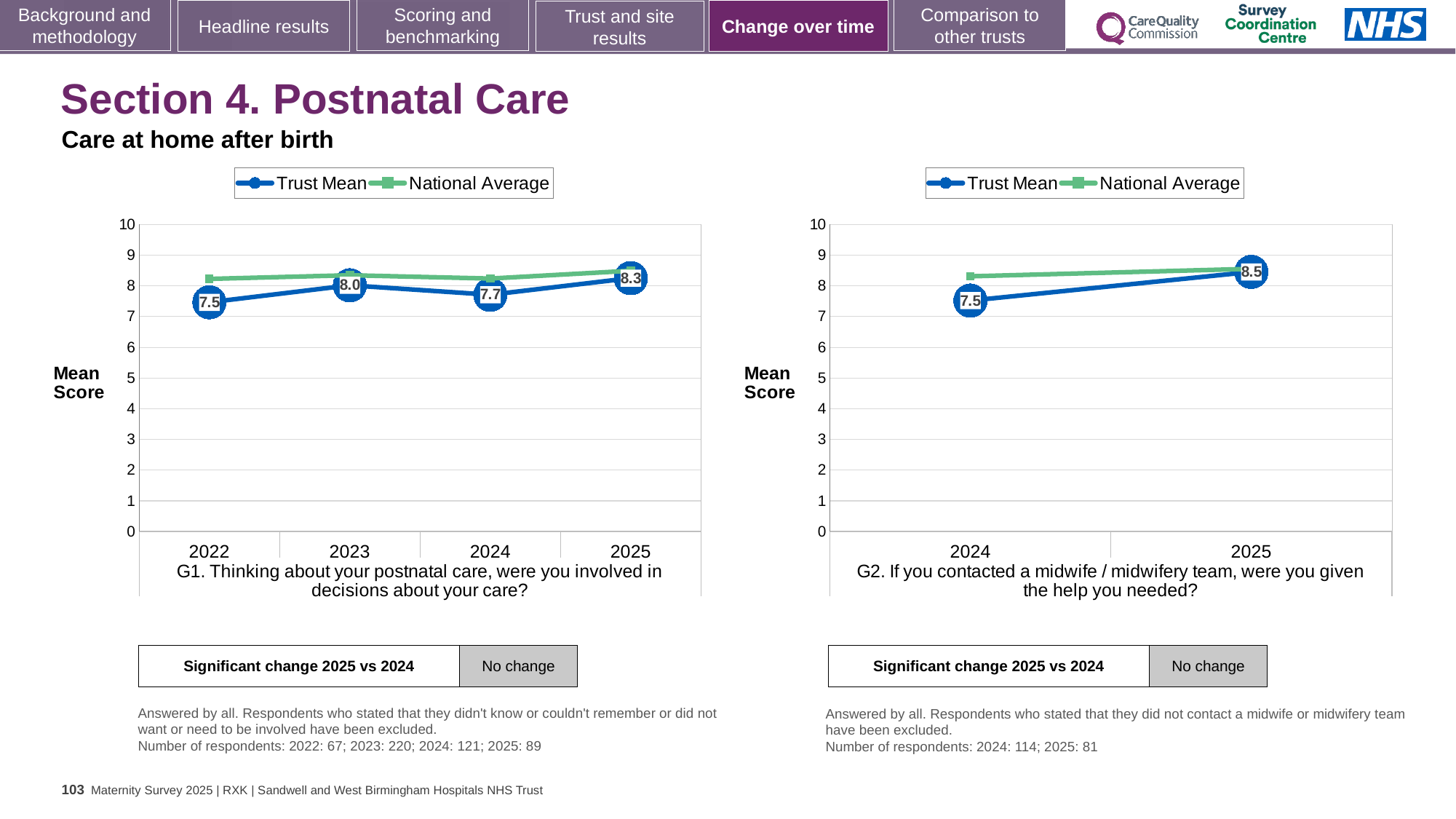
In the G2 chart on the right, does the Trust Mean rise or fall from 2024 to 2025? Rise In the G1 chart on the left, is the Trust Mean score higher in 2023 or in 2024? 2023 In the G1 chart on the left, what is the Trust Mean score for 2022? 7.5 In the G2 chart on the right, what is the Trust Mean score for 2025? 8.5 How many years are shown on the x axis of the G1 chart on the left? 4 In the G1 chart on the left, what is the Trust Mean score for 2025? 8.3 In the G2 chart on the right, what is the difference between the Trust Mean scores for 2025 and 2024? 1.0 In the G1 chart on the left, which year has the lowest Trust Mean score? 2022 In the G2 chart on the right, is the National Average for 2024 greater or less than 8? greater What kind of chart is the G1 chart on the left? Line chart How many series does the legend of the G2 chart on the right list? 2 In the G1 chart on the left, which year has the highest Trust Mean score? 2025